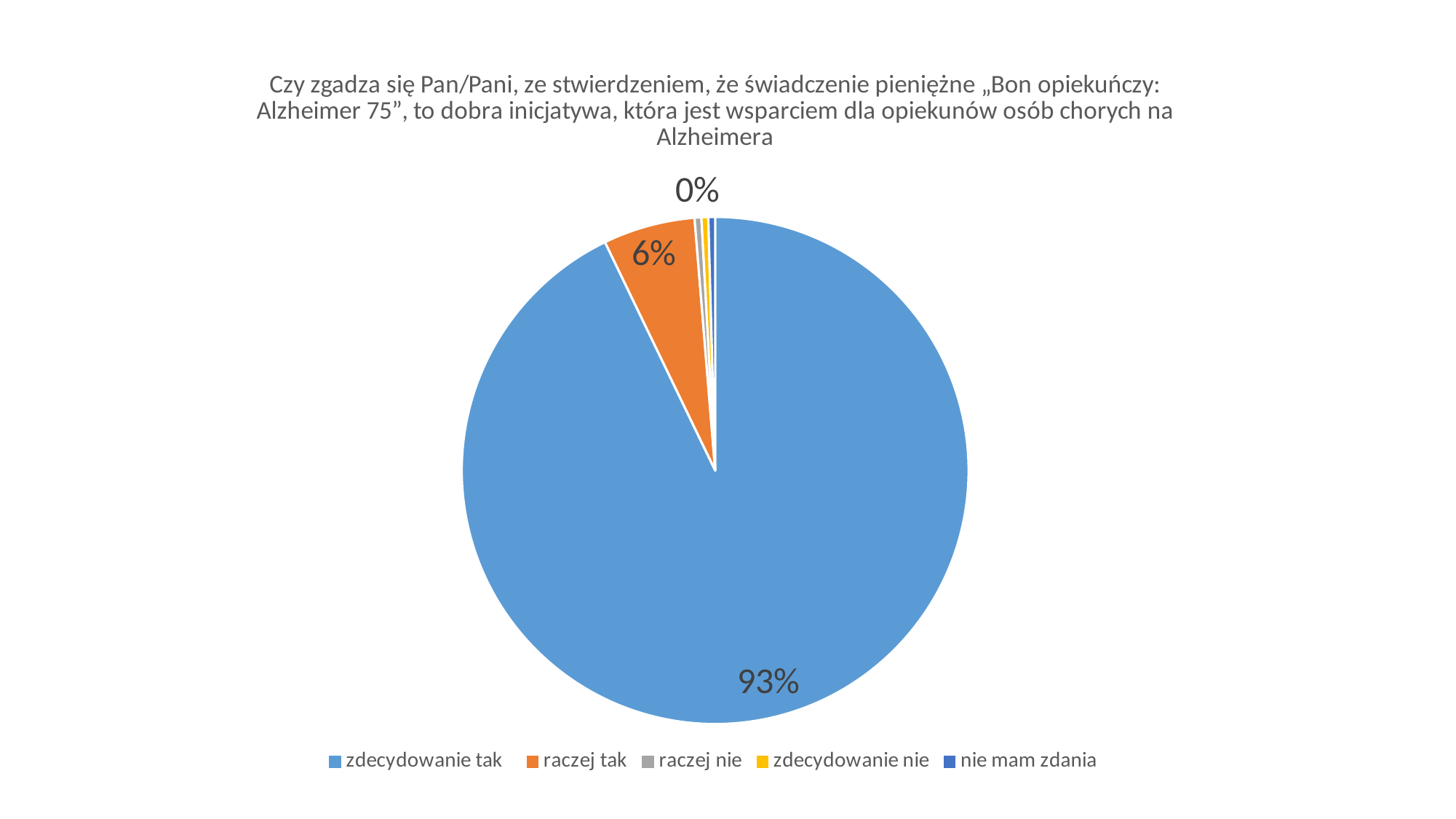
What percentage of respondents answered "zdecydowanie tak"? 93% Which is larger, the share for "zdecydowanie tak" or the share for "raczej tak"? zdecydowanie tak What kind of chart is shown on the slide? pie chart What colour is the "zdecydowanie tak" slice? blue What is the difference in percentage points between "zdecydowanie tak" and "raczej tak"? 87 percentage points What percentage of respondents answered "raczej tak"? 6% How many answer categories does the legend list? 5 What colour is the "raczej tak" slice? orange What share of the pie does the "raczej tak" slice represent? 6% Is the share for "zdecydowanie tak" greater or less than 50%? greater Which answer category has the largest share of the pie? zdecydowanie tak What is the combined share of "zdecydowanie tak" and "raczej tak"? 99%